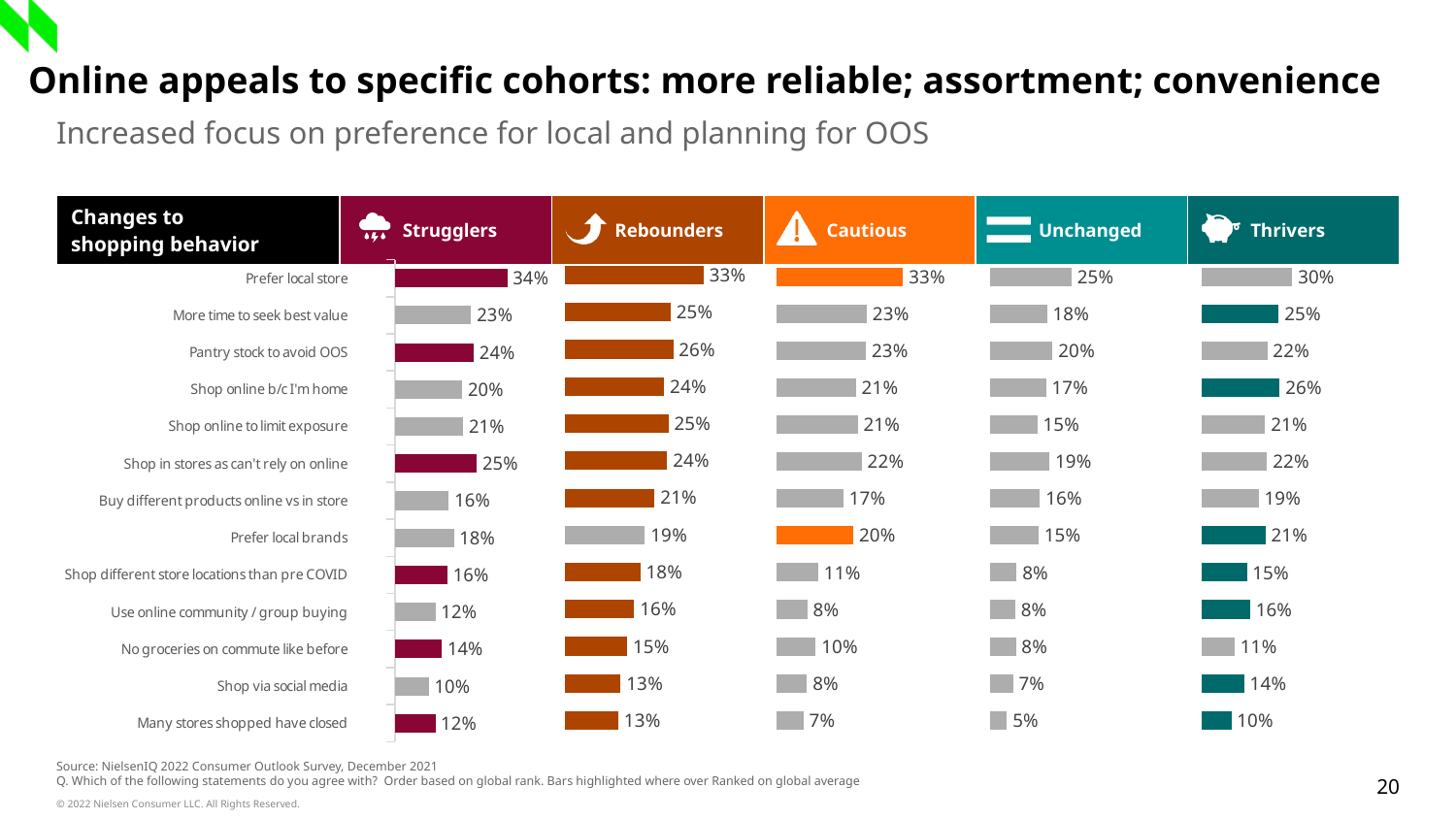
How many cohort charts are shown on the slide? 5 In the Cautious chart, which category has the highest value? Prefer local store In the Strugglers chart, what is the value for "Prefer local store"? 34% In the Unchanged chart, what is the value for "Many stores shopped have closed"? 5% In the Rebounders chart, what is the difference between "Prefer local store" and "Pantry stock to avoid OOS"? 7 percentage points In the Thrivers chart, which is larger: "Prefer local brands" or "Shop different store locations than pre COVID"? Prefer local brands In the Cautious chart, what is the value for "Use online community / group buying"? 8% In the Unchanged chart, what is the difference between "Prefer local store" and "Shop via social media"? 18 percentage points What type of chart is used for each cohort on the slide? Bar chart How many categories are shown in each of the charts on the slide? 13 In the Thrivers chart, what is the value for "Shop online b/c I'm home"? 26% In the Rebounders chart, which category has the lowest value? Shop via social media and Many stores shopped have closed (13%)